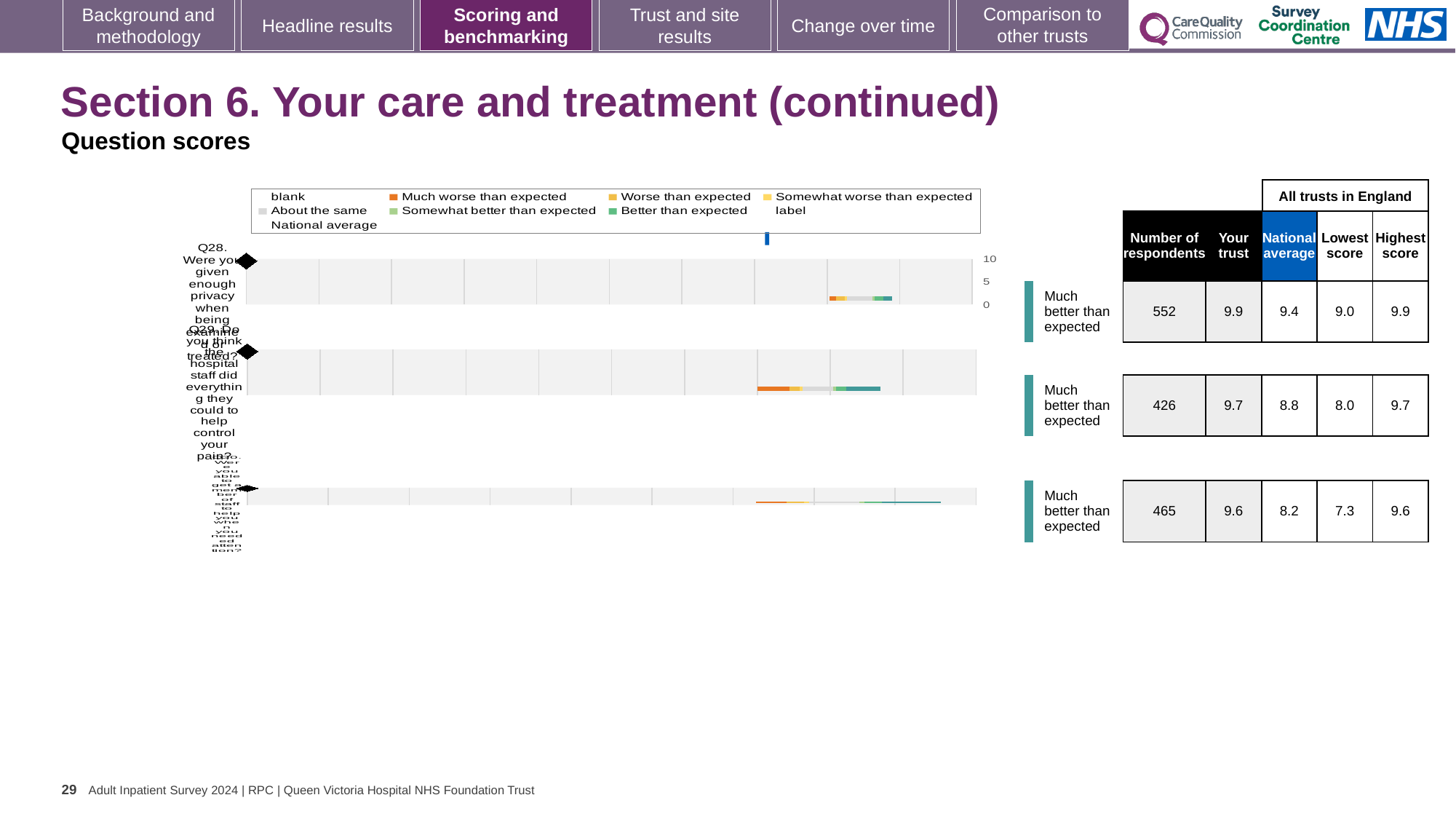
How many entries does the chart legend list? 9 Which is larger, the 'Your trust' score for Q28 or for Q30? Q28 Which question has the highest 'Your trust' score? Q28 What is the national average score for Q29 (hospital staff helping to control pain)? 8.8 What is the 'Your trust' score for Q28 (privacy when being examined or treated)? 9.9 What kind of chart is used to show the question scores for Q28, Q29 and Q30? bar chart What is the lowest score across all trusts in England for Q30 (able to get a member of staff to help when needed)? 7.3 What is the difference between the 'Your trust' score and the national average for Q28? 0.5 Which question has the lowest national average score? Q30 How many questions (Q28, Q29, Q30) are plotted on the chart? 3 What is the maximum value shown on the chart's score axis? 10 How many respondents answered Q29? 426